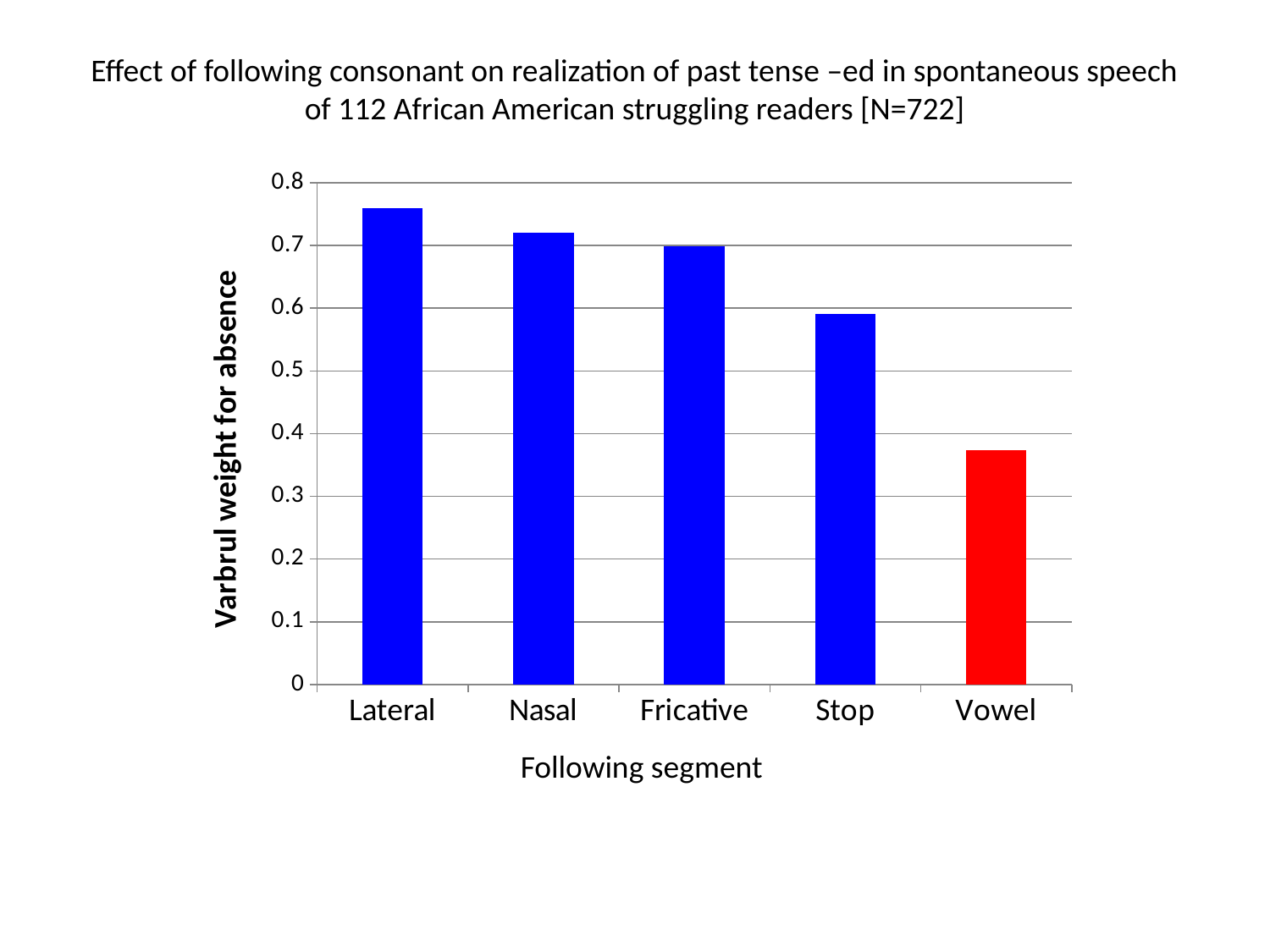
Which bar is coloured red rather than blue? Vowel Is the value for Vowel greater or less than 0.4? less Is the value for Stop greater or less than 0.5? greater What is the label of the y axis? Varbrul weight for absence Which following segment has the highest Varbrul weight for absence? Lateral How many following-segment categories are plotted on the x axis? 5 What kind of chart is shown on the slide? bar chart Is the value for Lateral greater or less than 0.7? greater Do the values rise or fall moving from Lateral to Vowel along the x axis? fall Which following segment has the lowest Varbrul weight for absence? Vowel Which has a larger Varbrul weight for absence, Lateral or Stop? Lateral Which has a larger Varbrul weight for absence, Stop or Vowel? Stop